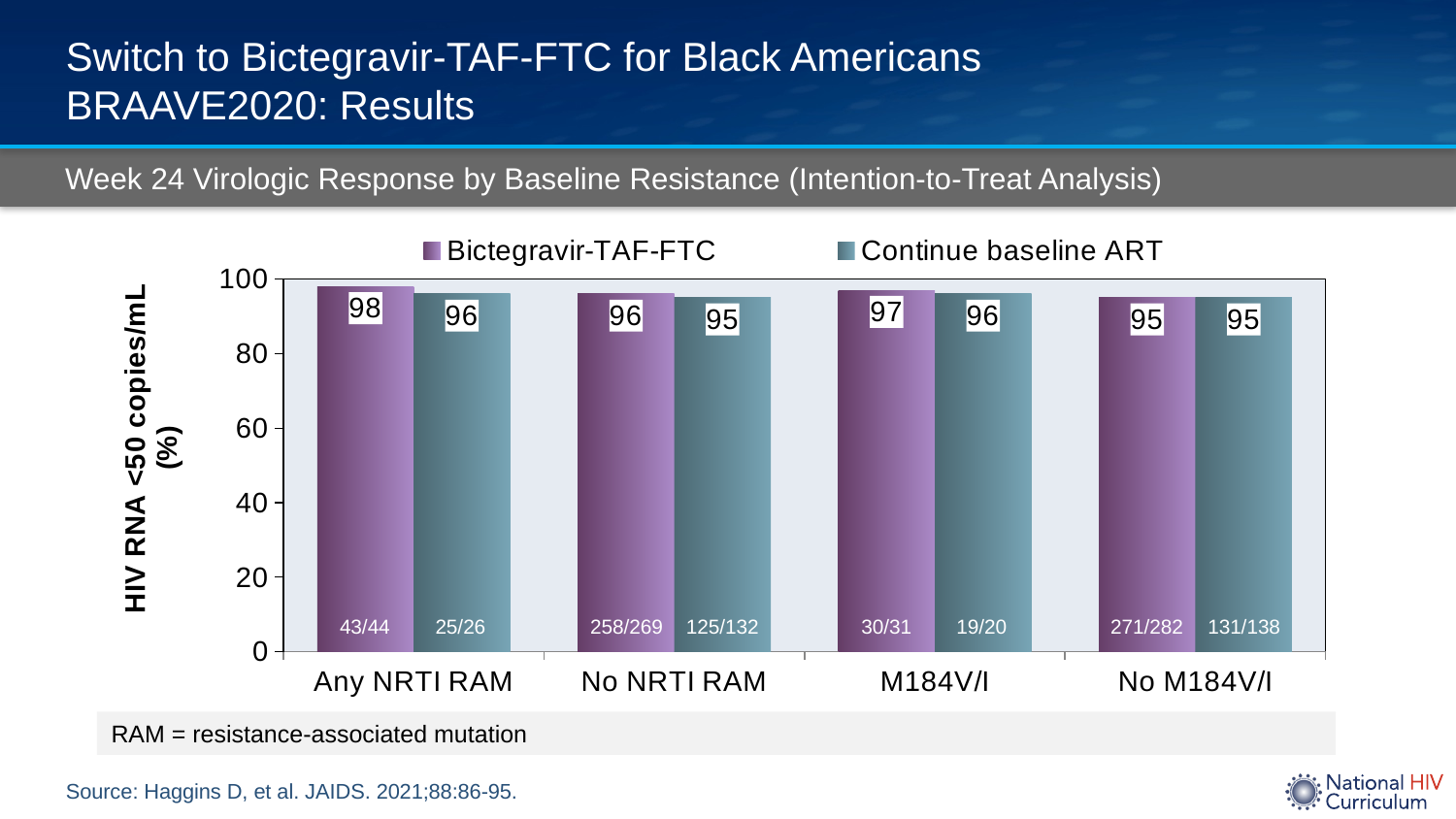
In the M184V/I category, which series has the larger value, Bictegravir-TAF-FTC or Continue baseline ART? Bictegravir-TAF-FTC What is the value for Bictegravir-TAF-FTC in the M184V/I category? 97 What fraction is printed on the Continue baseline ART bar in the No NRTI RAM category? 125/132 Which category has the highest value for Bictegravir-TAF-FTC? Any NRTI RAM What kind of chart is shown on the slide? Bar chart What is the value for Bictegravir-TAF-FTC in the Any NRTI RAM category? 98 What is the y-axis label of the chart? HIV RNA <50 copies/mL (%) What is the value for Continue baseline ART in the No M184V/I category? 95 How many categories are shown on the x axis? 4 How many series does the legend list? 2 What is the value for Continue baseline ART in the No NRTI RAM category? 95 What is the difference between the Bictegravir-TAF-FTC and Continue baseline ART values in the Any NRTI RAM category? 2